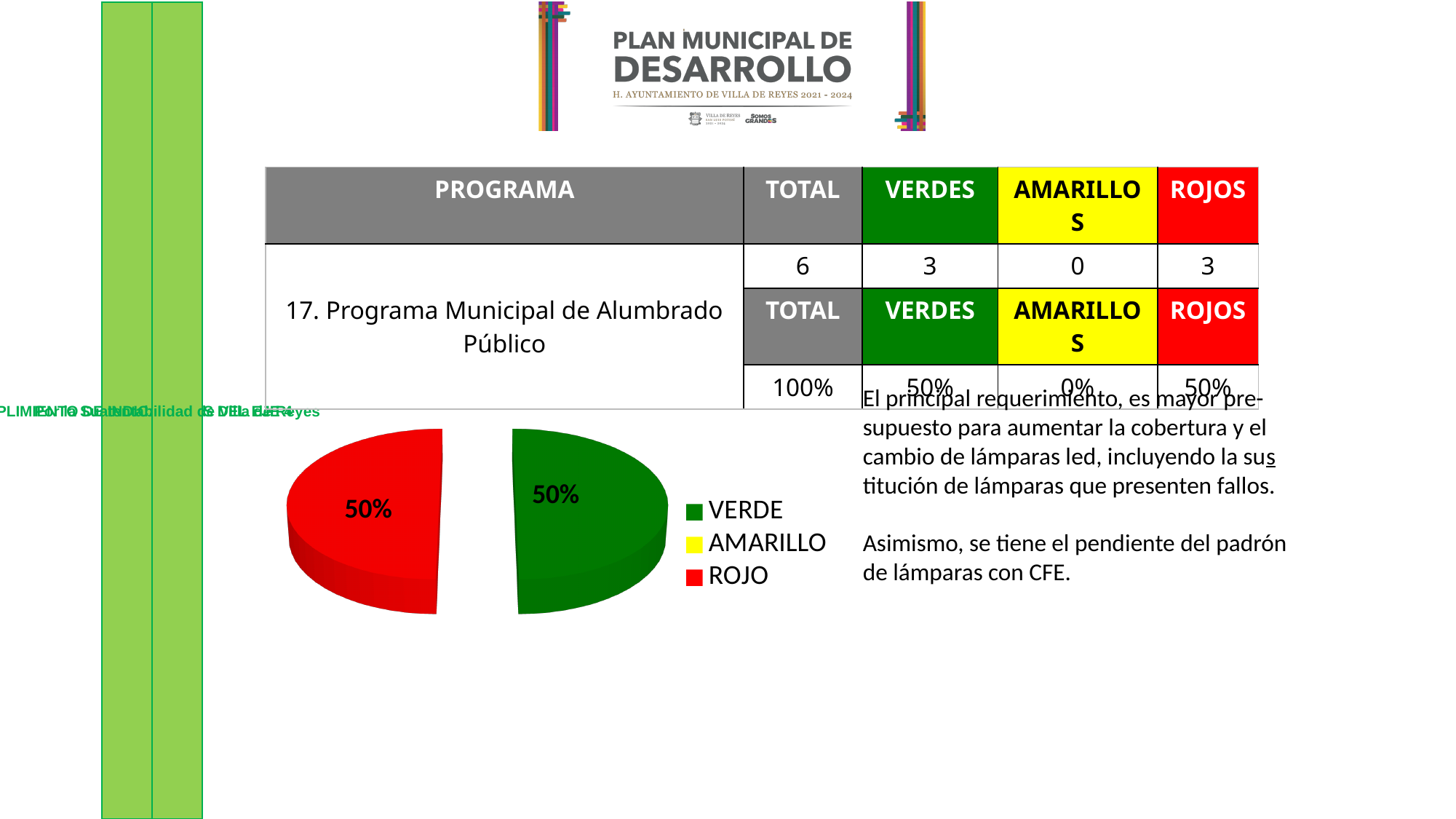
What share of the pie chart does VERDE represent? 50% What kind of chart is shown on the slide? pie chart Which legend entry of the pie chart has no visible slice? AMARILLO What share of the pie chart does ROJO represent? 50% What is the difference between the VERDE and ROJO shares in the pie chart? 0% How many entries does the legend of the pie chart list? 3 How many slices are visible in the pie chart? 2 What is the combined share of the VERDE and ROJO slices in the pie chart? 100% What colour is the VERDE slice in the pie chart? green